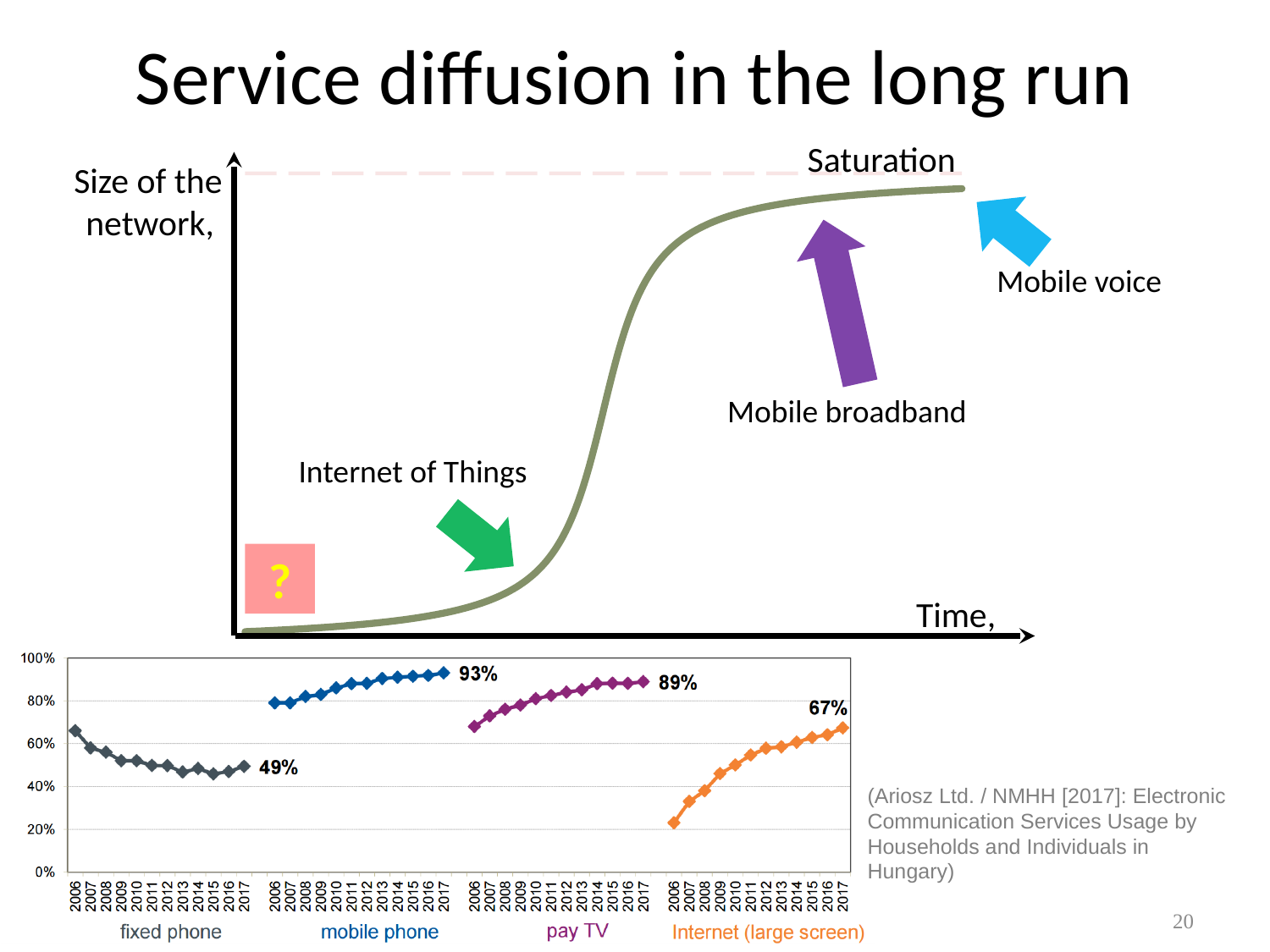
In the bottom chart, which service has the highest 2017 value? mobile phone In the bottom chart, does the fixed phone series rise or fall from 2006 to 2017? fall In the bottom chart, what is the 2017 value for fixed phone? 49% In the bottom chart, which service has the lowest 2017 value? fixed phone In the bottom chart, is the 2006 value for Internet (large screen) greater or less than 40%? less In the bottom chart, which is larger in 2017: pay TV or Internet (large screen)? pay TV In the bottom chart, what is the 2017 value for pay TV? 89% In the bottom chart, what is the 2017 value for mobile phone? 93% In the bottom chart, what is the 2017 value for Internet (large screen)? 67% In the bottom chart, how many services are plotted? 4 In the bottom chart, what is the difference between the 2017 values for mobile phone and fixed phone? 44% In the top chart, what label is shown next to the dashed line at the top of the S-curve? Saturation